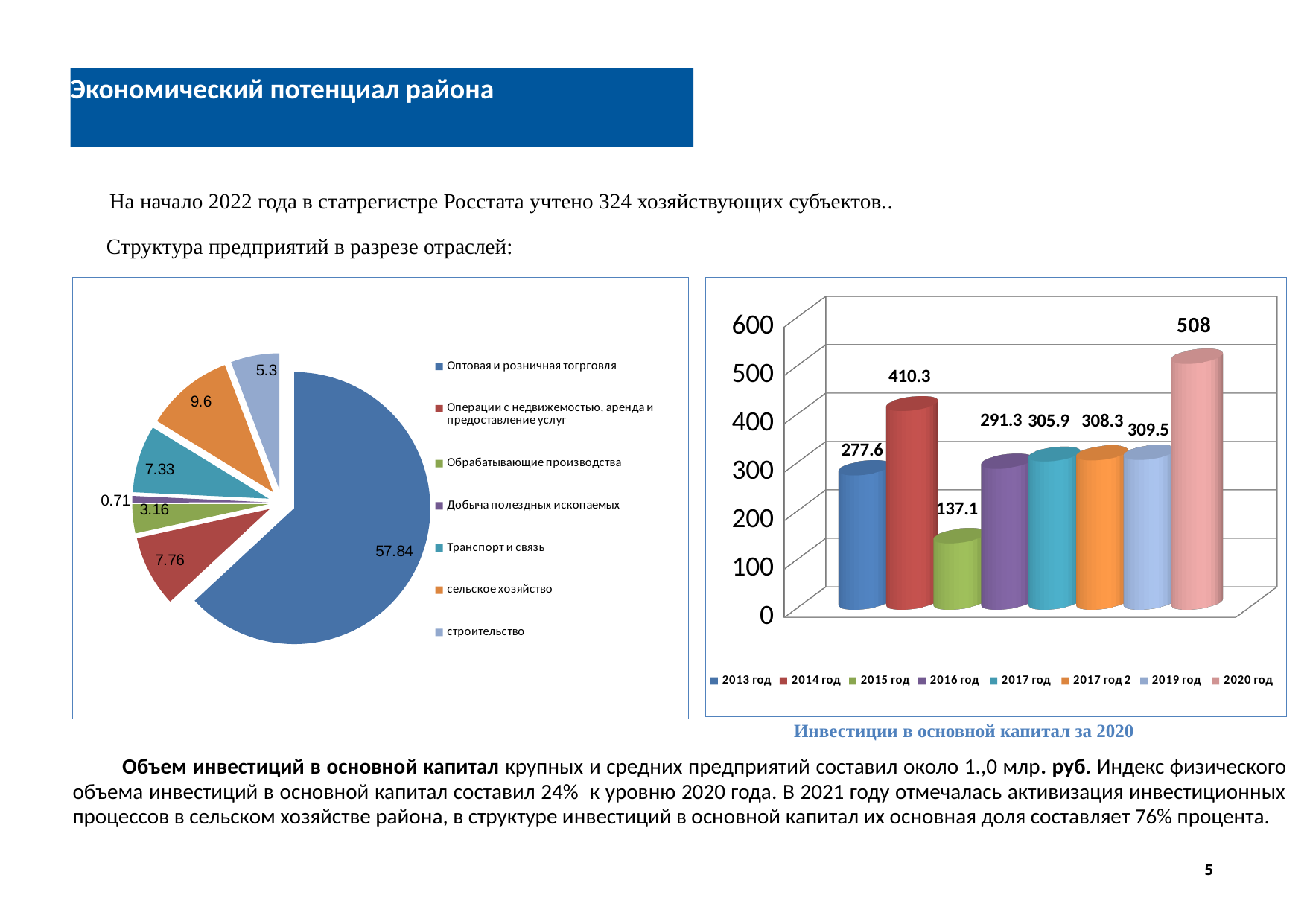
In the bar chart on the right, what is the value for 2014 год? 410.3 In the bar chart on the right, which year has the highest value? 2020 год In the pie chart on the left, what is the value for сельское хозяйство? 9.6 In the bar chart on the right, what is the value for 2015 год? 137.1 In the pie chart on the left, which category has the smallest slice? Добыча полезных ископаемых In the pie chart on the left, what is the value for Оптовая и розничная торговля? 57.84 What type of chart is shown on the right side of the slide? Bar chart In the bar chart on the right, how many series does the legend list? 8 In the pie chart on the left, how many slices are there? 7 In the pie chart on the left, which is larger: Транспорт и связь or строительство? Транспорт и связь In the bar chart on the right, what is the difference between the values for 2020 год and 2013 год? 230.4 In the bar chart on the right, which year has the lowest value? 2015 год